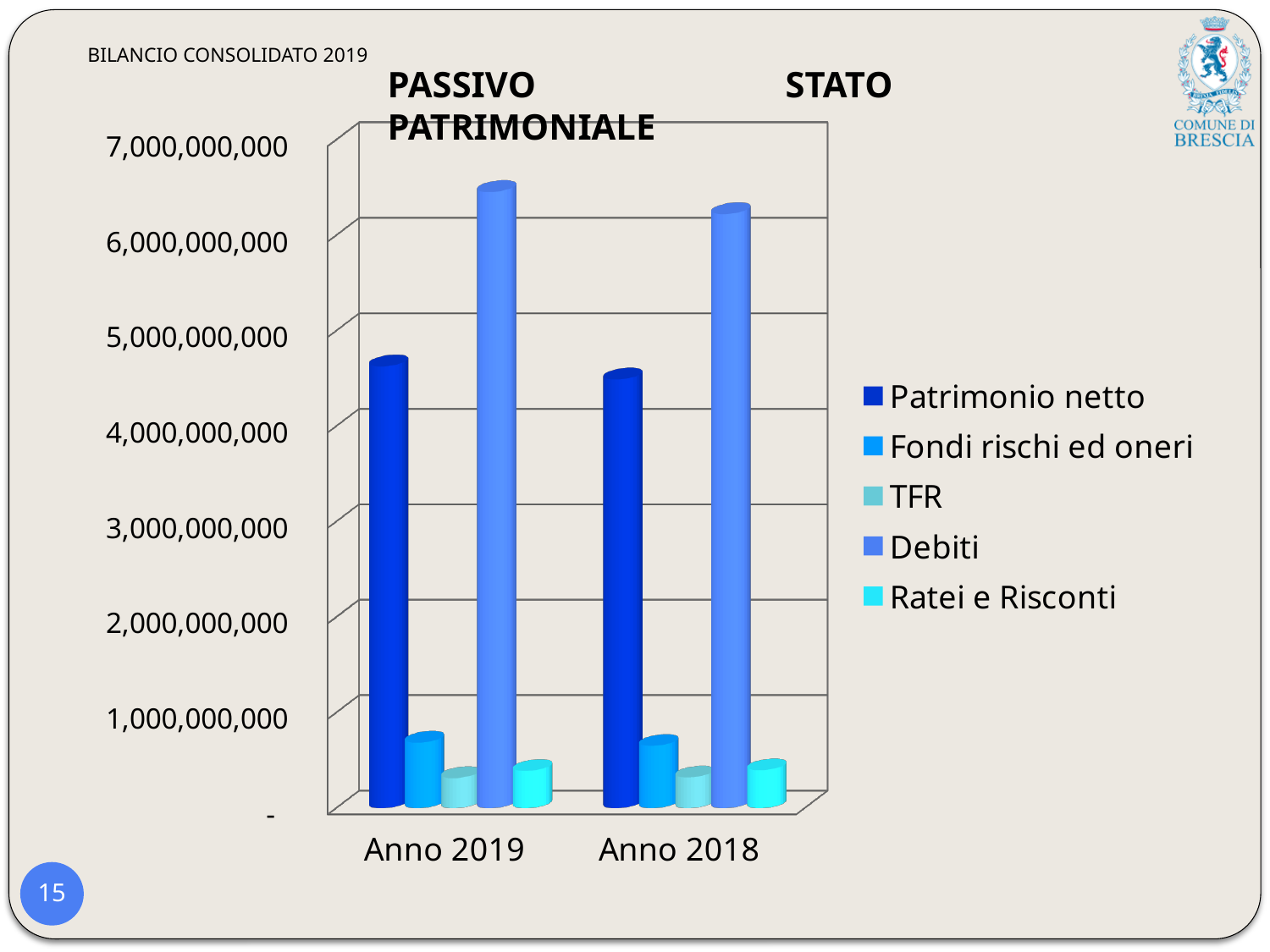
Is the value for Debiti in Anno 2018 greater or less than 5,000,000,000? greater Is the value for Patrimonio netto in Anno 2018 greater or less than 4,000,000,000? greater In Anno 2018, which is larger: Debiti or Patrimonio netto? Debiti Is the value for Fondi rischi ed oneri in Anno 2019 greater or less than 1,000,000,000? less How many categories are shown on the x axis? 2 What is the title of the chart? PASSIVO STATO PATRIMONIALE Which series has the highest value in Anno 2018? Debiti Which series has the highest value in Anno 2019? Debiti What kind of chart is shown on the slide? Bar chart How many series does the legend list? 5